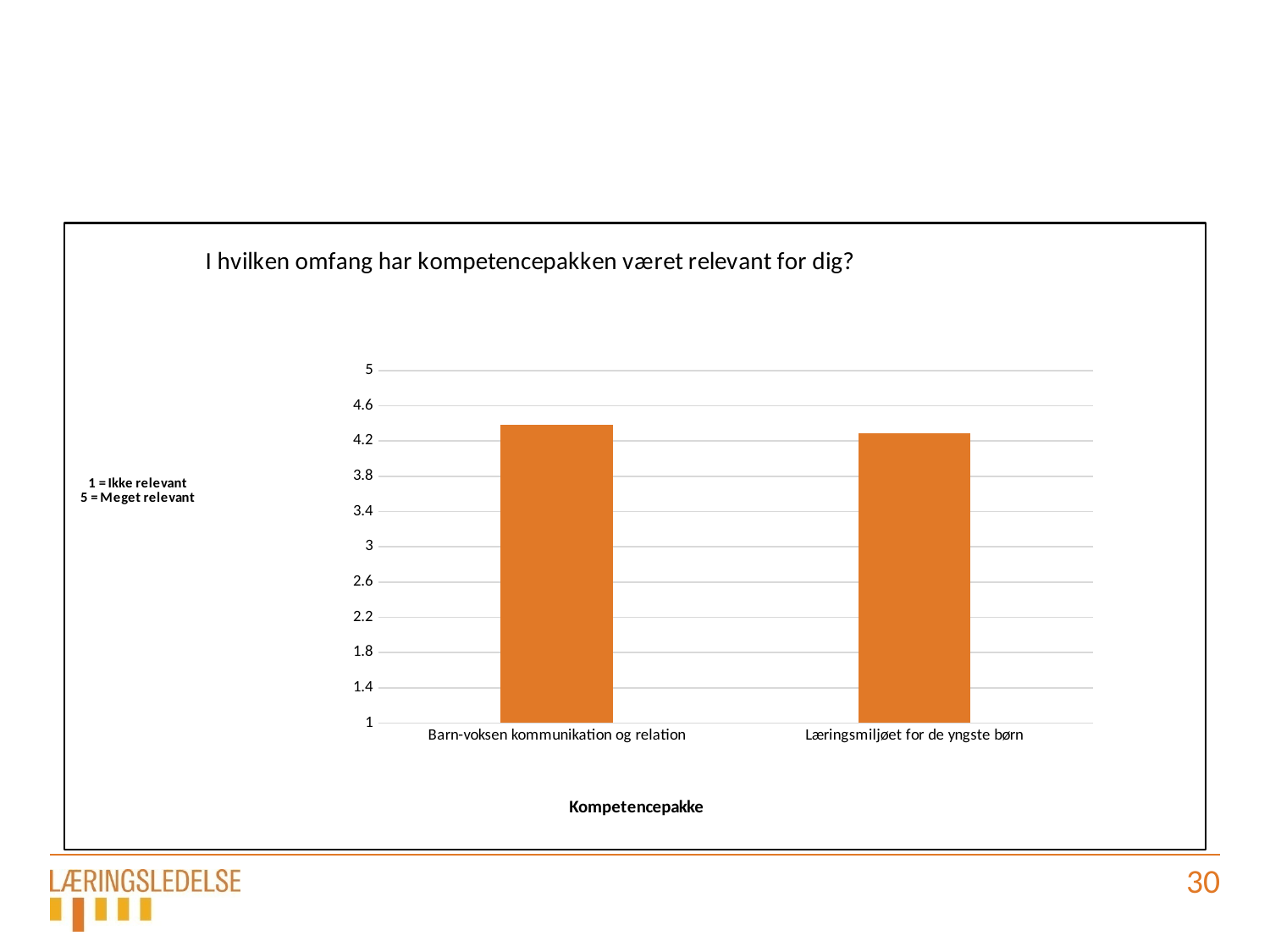
Is the value for Barn-voksen kommunikation og relation greater or less than 4.6? less Is the value for Læringsmiljøet for de yngste børn greater or less than 4.2? greater What is the title of the chart? I hvilken omfang har kompetencepakken været relevant for dig? What kind of chart is shown on the slide? bar chart Is the value for Læringsmiljøet for de yngste børn greater or less than 3.8? greater What is the label of the x axis of the chart? Kompetencepakke How many categories are plotted on the x axis of the chart? 2